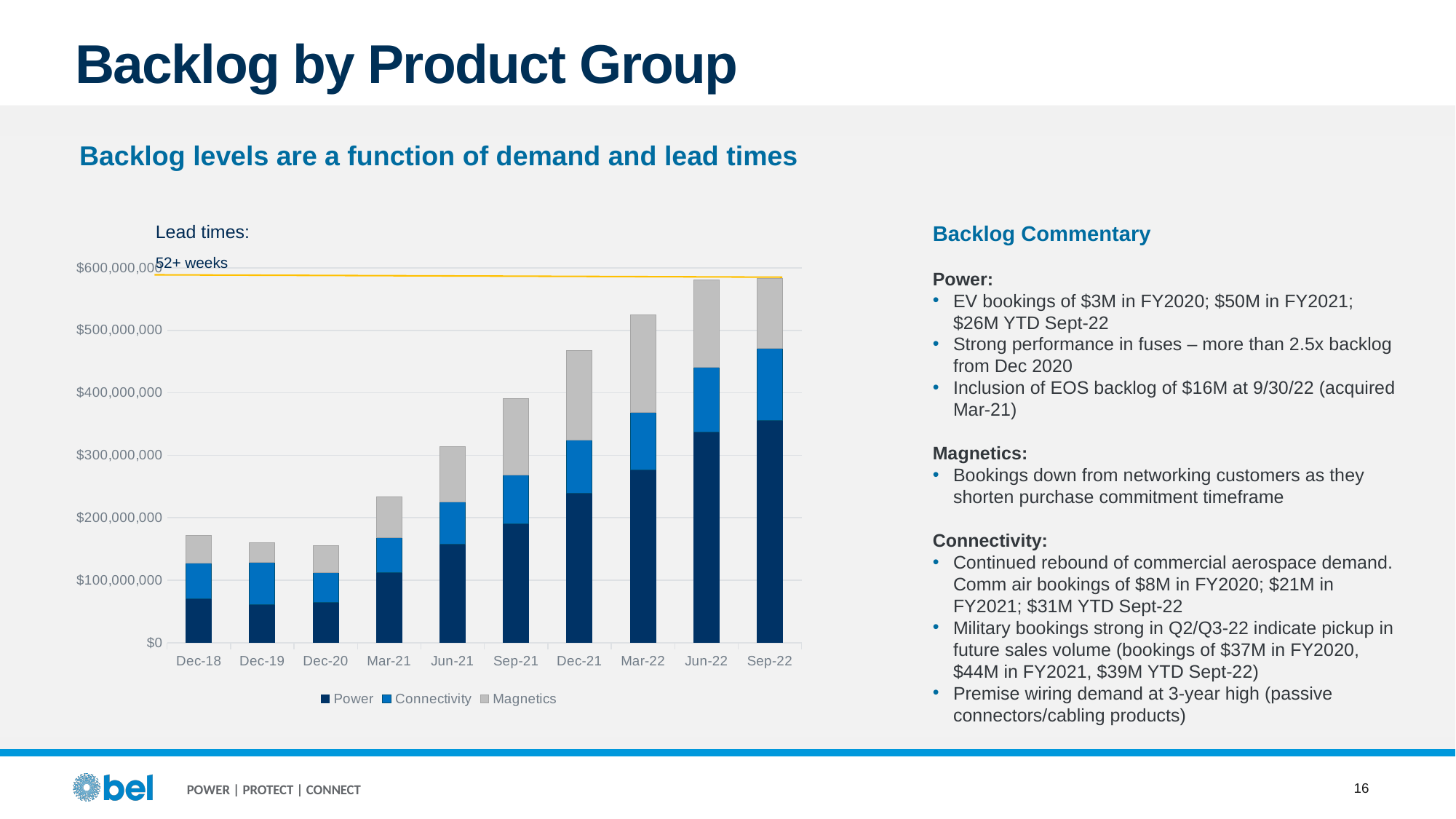
How many time periods are shown on the x axis of the chart? 10 Is the total backlog for Dec-21 greater or less than $400,000,000? greater What kind of chart is shown on the slide? Stacked bar chart What lead time is labelled on the line drawn across the top of the chart? 52+ weeks How many series does the chart legend list? 3 Is the total backlog for Sep-22 greater or less than $500,000,000? greater Which period has the larger Power backlog, Dec-18 or Sep-22? Sep-22 Is the total backlog for Dec-20 greater or less than $200,000,000? less Which period has the larger total backlog, Mar-21 or Dec-21? Dec-21 Does the total backlog generally rise or fall from Dec-20 to Sep-22? rise Which series are listed in the chart legend? Power, Connectivity, Magnetics